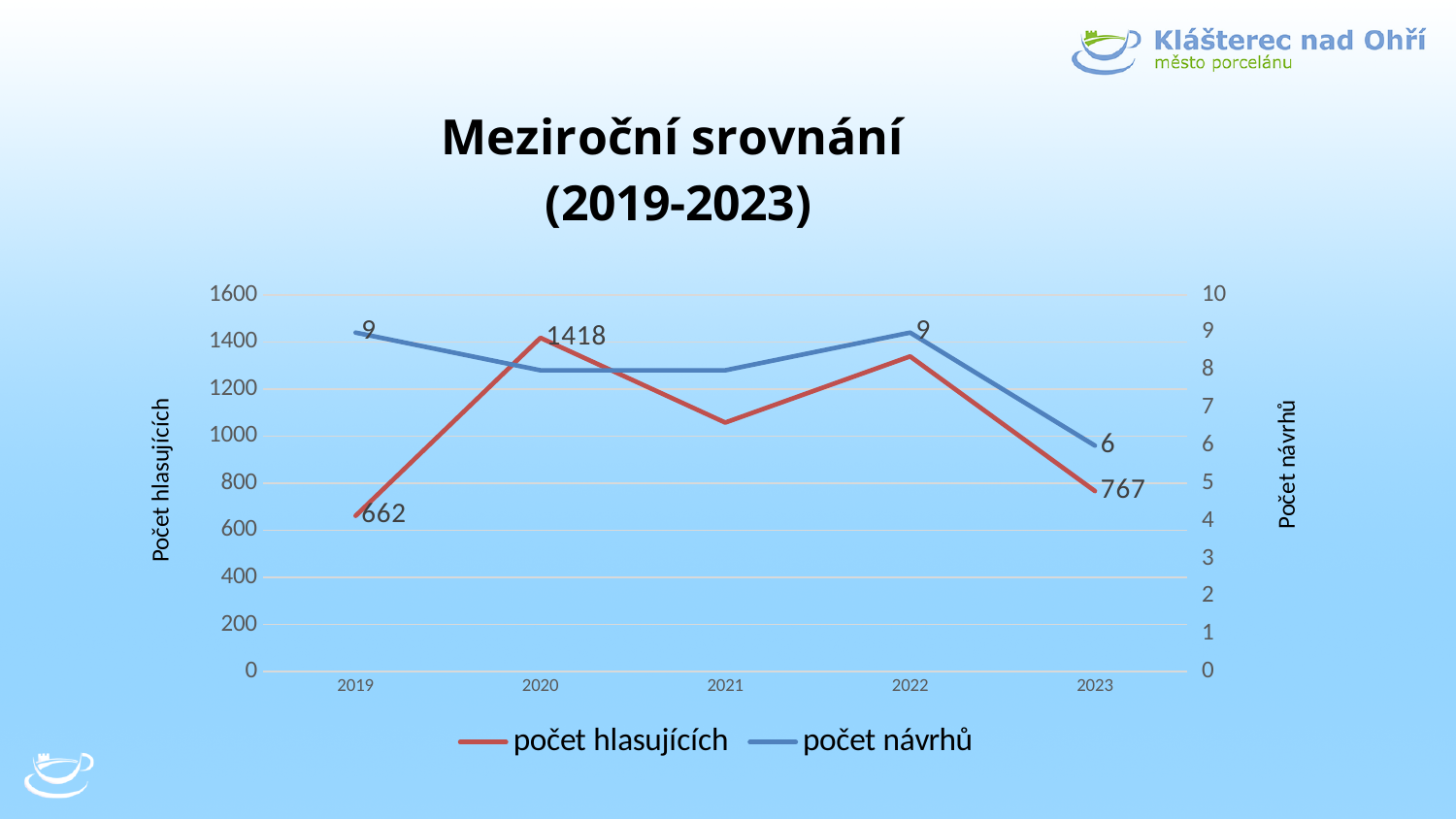
What is the value of počet hlasujících in 2020? 1418 What is the value of počet návrhů in 2019? 9 In which year was počet hlasujících lowest? 2019 Is the value of počet hlasujících in 2021 greater or less than 1000? greater What is the value of počet návrhů in 2023? 6 In which year was počet hlasujících highest? 2020 What is the value of počet hlasujících in 2023? 767 By how much did počet hlasujících increase from 2019 to 2020? 756 What is the value of počet hlasujících in 2019? 662 How many series does the legend list? 2 What kind of chart is shown on the slide? line chart What is the difference between počet návrhů in 2022 and in 2023? 3